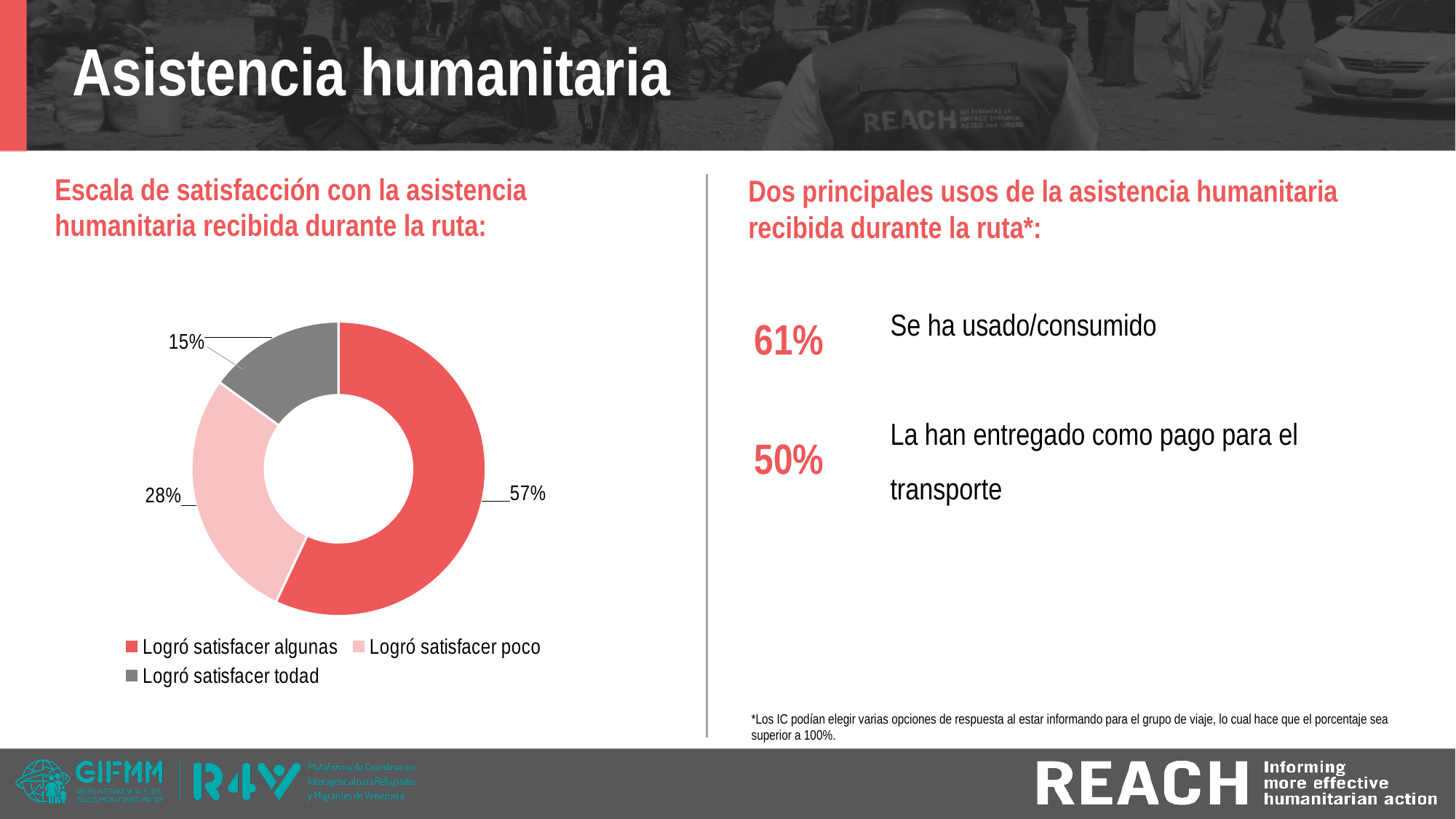
What kind of chart is shown on the slide? Pie chart (donut) Which category has the largest share of the pie chart? Logró satisfacer algunas How many entries does the legend of the pie chart list? 3 Which is larger in the pie chart: "Logró satisfacer poco" or "Logró satisfacer todad"? Logró satisfacer poco What is the difference in percentage points between "Logró satisfacer poco" and "Logró satisfacer todad"? 13 What percentage of the pie chart corresponds to "Logró satisfacer todad"? 15% Which category has the smallest share of the pie chart? Logró satisfacer todad Which colour represents "Logró satisfacer todad" in the pie chart? Gray What is the difference in percentage points between "Logró satisfacer algunas" and "Logró satisfacer poco"? 29 What percentage of the pie chart corresponds to "Logró satisfacer poco"? 28% What percentage of the pie chart corresponds to "Logró satisfacer algunas"? 57% How many slices does the pie chart have? 3